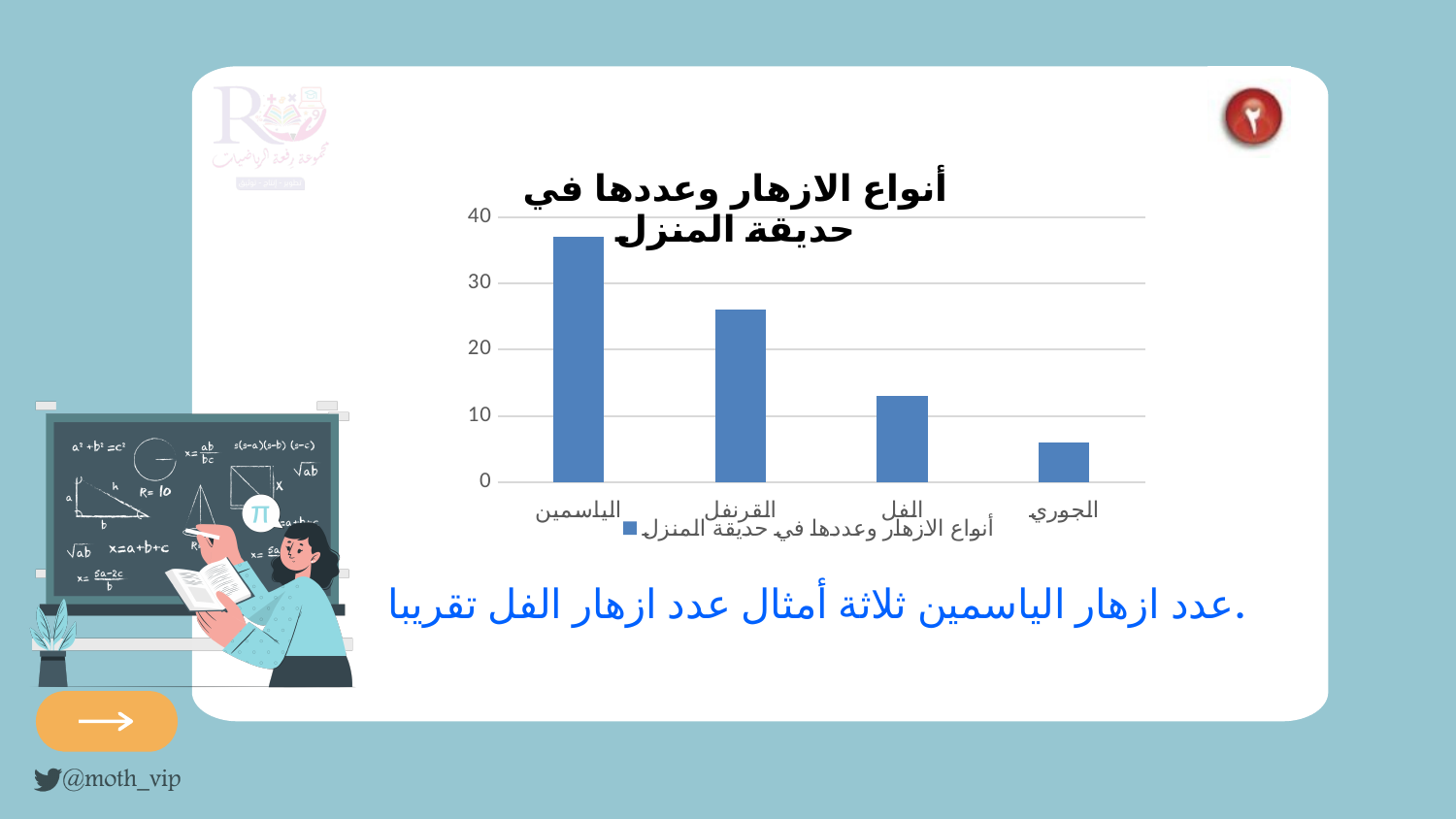
Which has a larger value, القرنفل or الفل? القرنفل Which flower type has the highest bar in the chart? الياسمين What is the title of the chart? أنواع الازهار وعددها في حديقة المنزل What kind of chart is shown on the slide? bar chart Is the value for الياسمين greater or less than 30? greater Is the value for الجوري greater or less than 10? less Which has a larger value, الجوري or الياسمين? الياسمين Is the value for القرنفل greater or less than 20? greater How many flower types (categories) are shown on the x axis of the chart? 4 Which flower type has the lowest bar in the chart? الجوري Do the bar values rise or fall moving from الياسمين to الجوري along the x axis? fall How many series does the chart legend list? 1